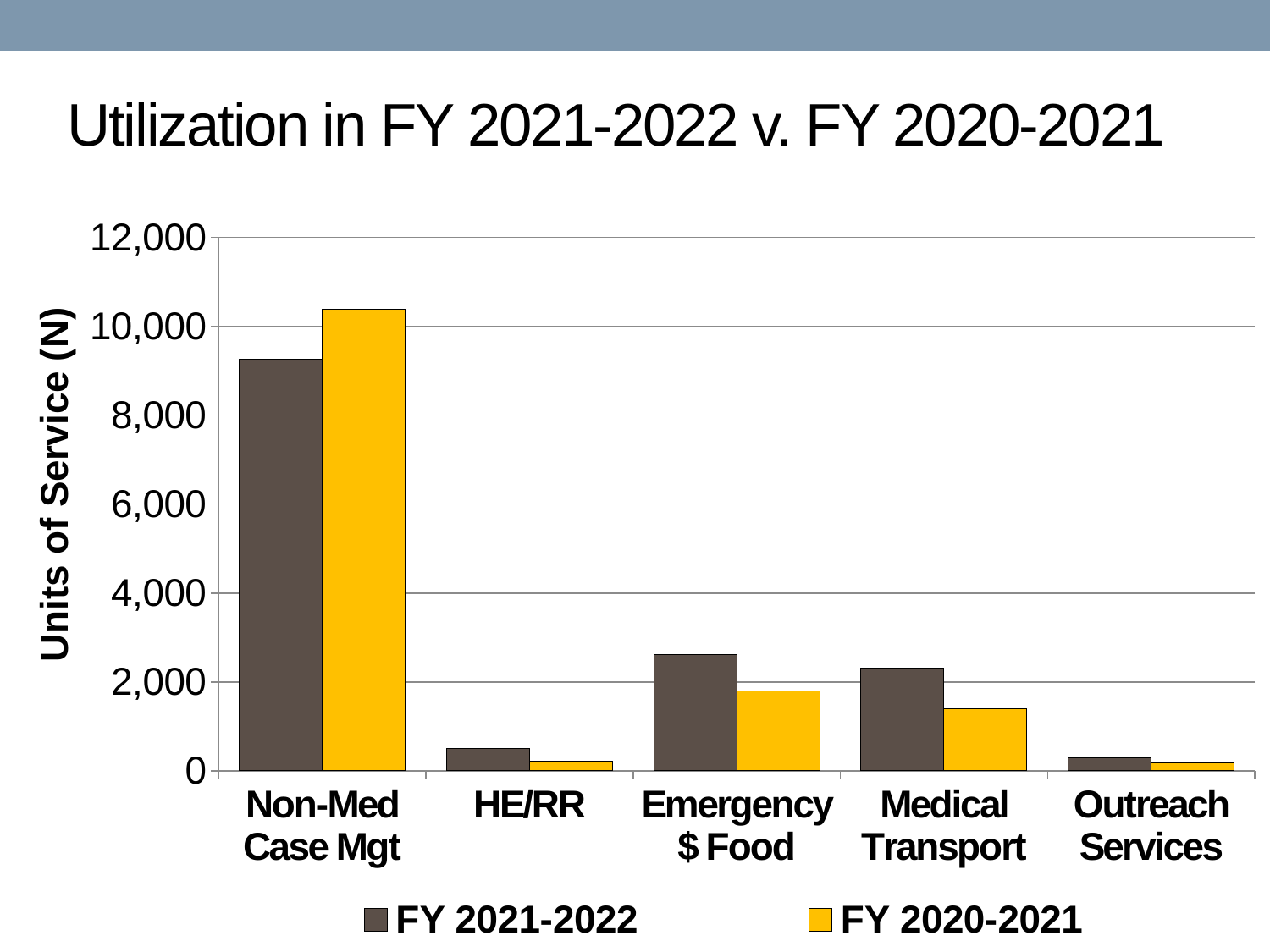
How many service categories are shown on the x axis? 5 Which category has the highest value for FY 2020-2021? Non-Med Case Mgt How many series does the legend list? 2 What is the title of the vertical axis? Units of Service (N) For Non-Med Case Mgt, which is larger: the FY 2021-2022 value or the FY 2020-2021 value? FY 2020-2021 Is the FY 2020-2021 value for Non-Med Case Mgt greater or less than 10,000? greater Is the FY 2021-2022 value for Non-Med Case Mgt greater or less than 10,000? less What kind of chart is shown on the slide? bar chart Is the FY 2021-2022 value for Emergency $ Food greater or less than 2,000? greater For Medical Transport, which is larger: the FY 2021-2022 value or the FY 2020-2021 value? FY 2021-2022 Which category has the highest value for FY 2021-2022? Non-Med Case Mgt